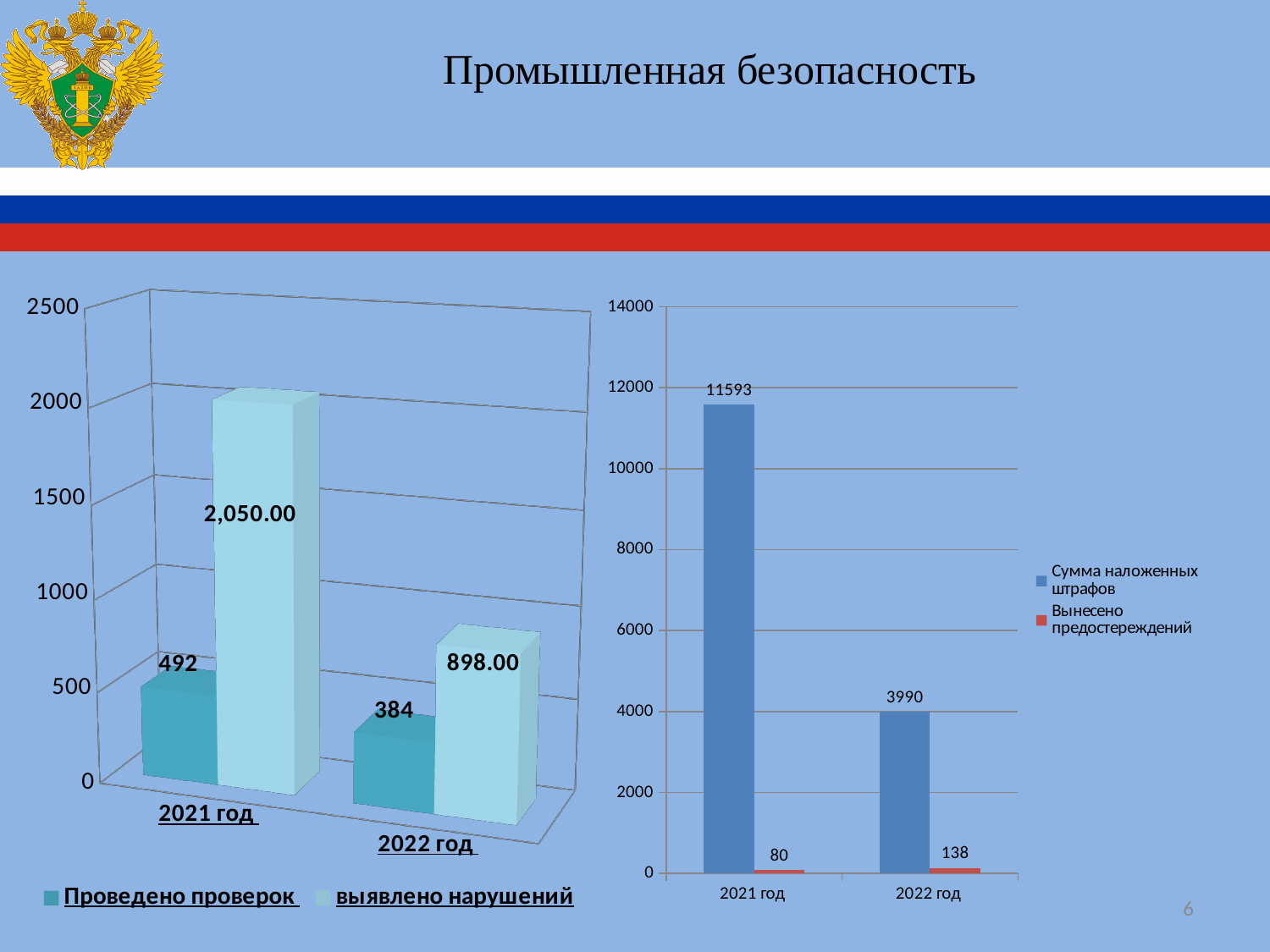
In the right chart, how many categories are shown on the x axis? 2 In the left chart, what is the difference between выявлено нарушений in 2021 год and 2022 год? 1,152.00 In the left chart, how many series does the legend list? 2 In the right chart, what is the value of Сумма наложенных штрафов for 2021 год? 11593 In the left chart, what is the value of Проведено проверок for 2021 год? 492 In the right chart, what is the value of Вынесено предостережений for 2022 год? 138 In the left chart, which year has the higher value for Проведено проверок? 2021 год In the left chart, what is the value of выявлено нарушений for 2022 год? 898.00 In the right chart, which year has the higher value for Вынесено предостережений? 2022 год In the right chart, what is the difference between Сумма наложенных штрафов in 2021 год and 2022 год? 7603 What kind of chart is the right chart? bar chart In the left chart, does the value of Проведено проверок rise or fall from 2021 год to 2022 год? fall